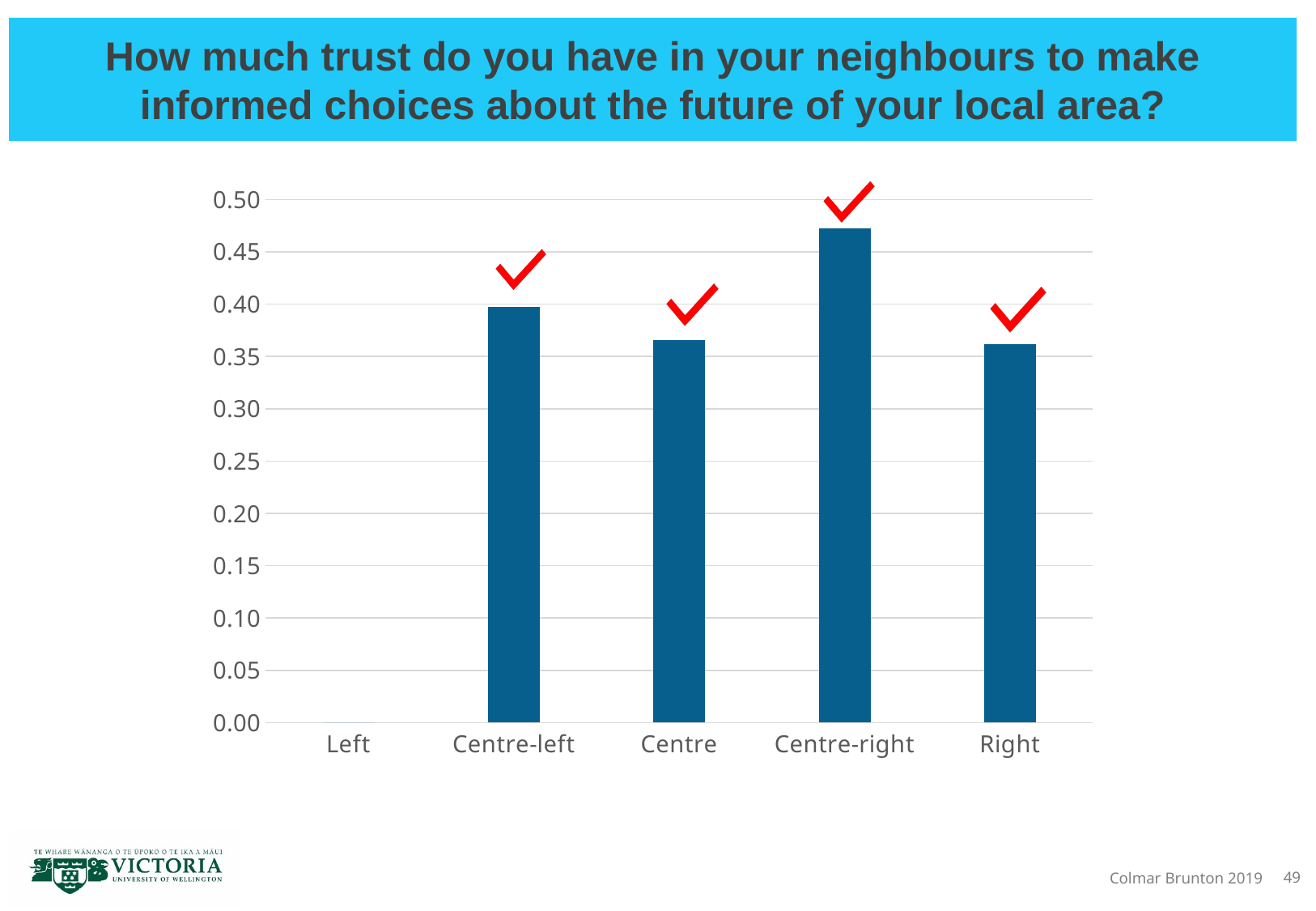
Is the value for Centre-left greater or less than 0.35? greater Is the value for Centre greater or less than 0.30? greater What is the title of the slide containing the chart? How much trust do you have in your neighbours to make informed choices about the future of your local area? Is the value for Centre-right greater or less than 0.45? greater What colour are the bars in the chart? Blue What kind of chart is shown on the slide? Bar chart Which category has the lowest value in the chart? Left Which category has the highest value in the chart? Centre-right How many categories are shown on the x axis of the chart? 5 Which is larger, the value for Centre-left or the value for Centre-right? Centre-right